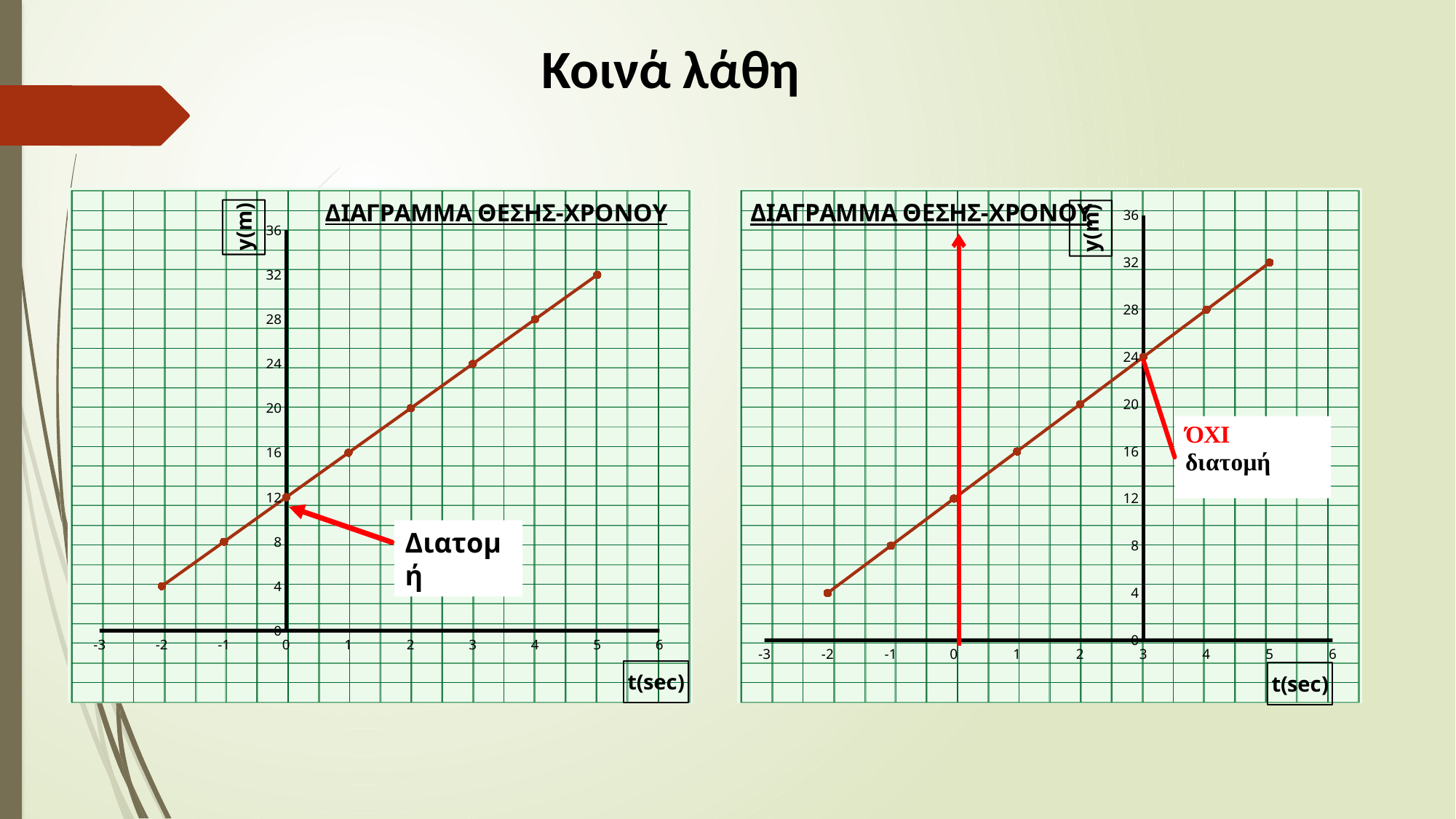
On the left chart, at which t(sec) value is y(m) lowest? -2 On the left chart, what is the value of y(m) at t = 5 sec? 32 On the left chart, does y(m) rise or fall as t(sec) increases? rise On the right chart, at which t(sec) value is y(m) highest? 5 On the left chart, what is the value of y(m) at t = -2 sec? 4 On the right chart, which is larger: y(m) at t = 4 sec or y(m) at t = 1 sec? t = 4 sec On the left chart, how many data points are plotted? 8 On the left chart, what is the value of y(m) at t = 0 sec? 12 What type of chart is shown on the left? line chart On the left chart, what is the difference in y(m) between t = 5 sec and t = 0 sec? 20 What is the title of the right chart? ΔΙΑΓΡΑΜΜΑ ΘΕΣΗΣ-ΧΡΟΝΟΥ On the right chart, what is the value of y(m) at t = 3 sec? 24